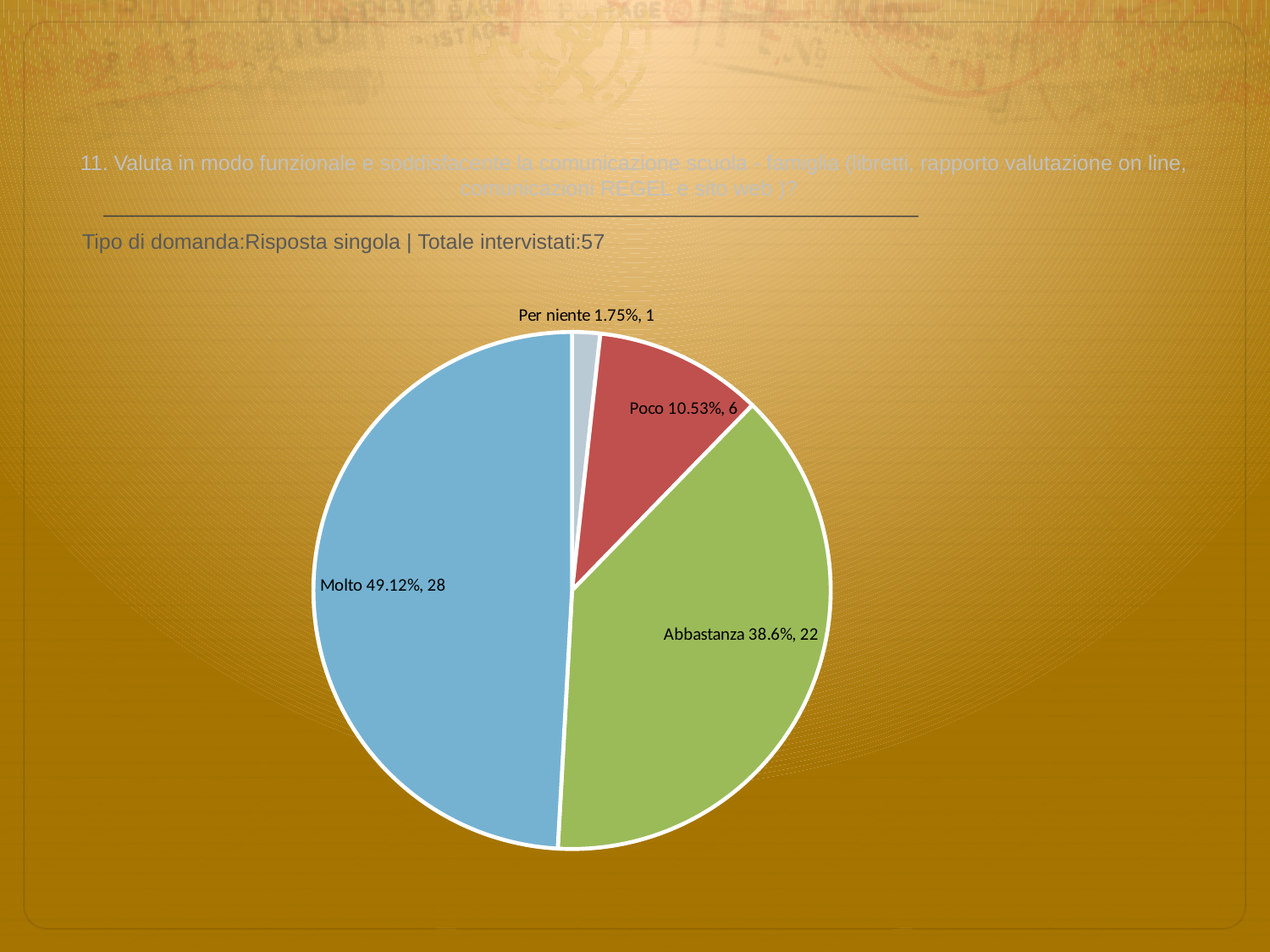
Which category has the largest slice? Molto How many respondents answered Per niente? 1 What kind of chart is shown on the slide? pie chart What colour is the Molto slice? blue What percentage share does the Abbastanza slice have? 38.6% What percentage share does the Molto slice have? 49.12% What is the total number of respondents shown on the slide? 57 Which category has the smallest slice? Per niente How many slices does the pie chart have? 4 Which slice is larger, Poco or Abbastanza? Abbastanza How many respondents answered Poco? 6 What is the difference in respondent count between Molto and Abbastanza? 6